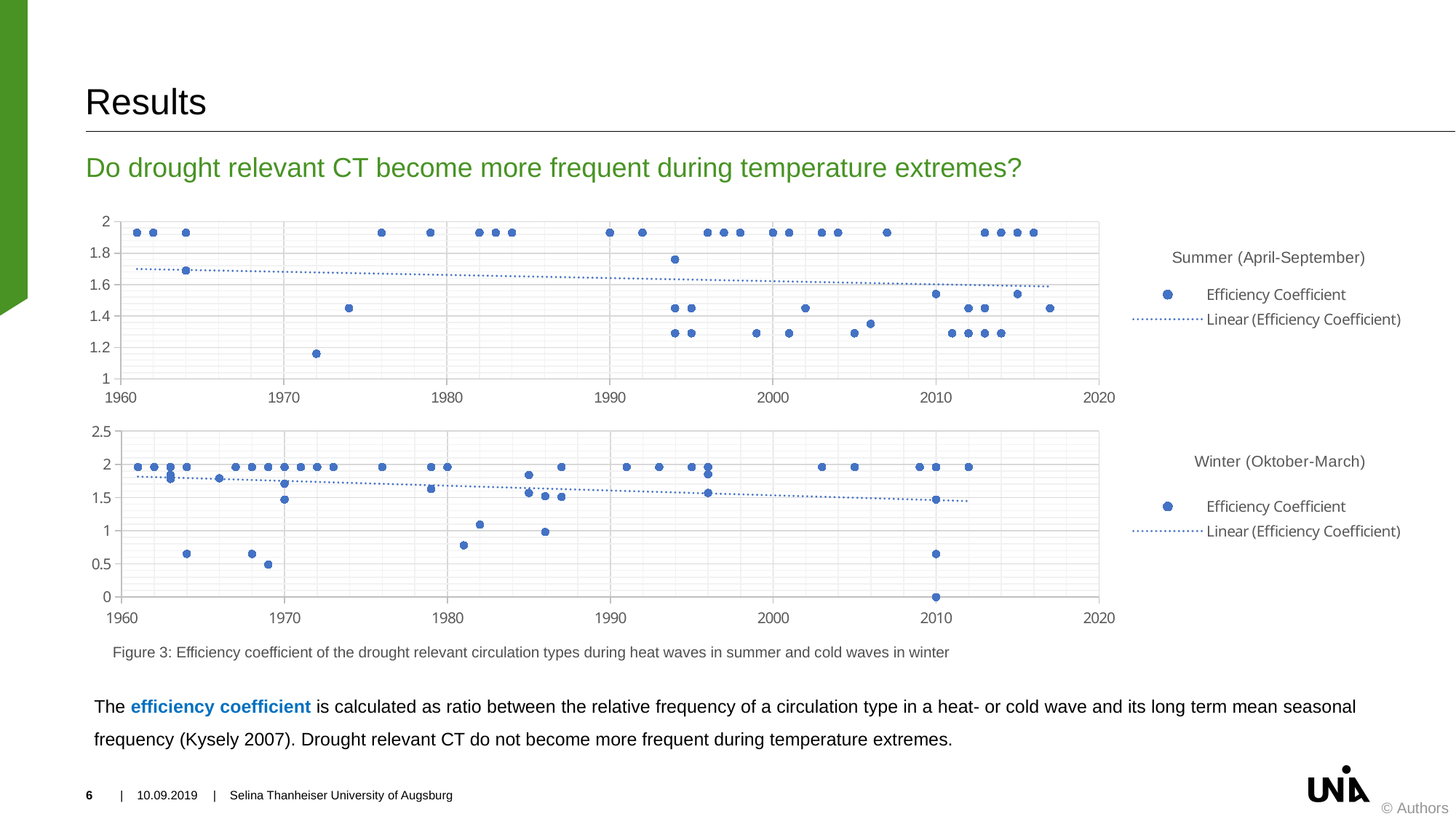
What is the name of the second legend entry in the Summer (April-September) chart? Linear (Efficiency Coefficient) In the Winter (Oktober-March) chart, does the dotted linear trend line rise or fall along the x axis? fall In the Summer (April-September) chart, is the lower value plotted for 1964 greater or less than 1.6? greater In the Summer (April-September) chart, does the dotted linear trend line rise or fall from 1960 to 2020? fall In the Summer (April-September) chart, is the value plotted for 1974 greater or less than 1.6? less What is the highest value shown on the y axis of the Winter (Oktober-March) chart? 2.5 In the Summer (April-September) chart, in which year does the lowest efficiency coefficient occur? 1972 What kind of chart is the Summer (April-September) chart? scatter chart In the Winter (Oktober-March) chart, is the lowest value plotted for 2010 greater or less than 0.5? less How many entries does the legend of the Winter (Oktober-March) chart list? 2 In the Winter (Oktober-March) chart, in which year does the lowest efficiency coefficient occur? 2010